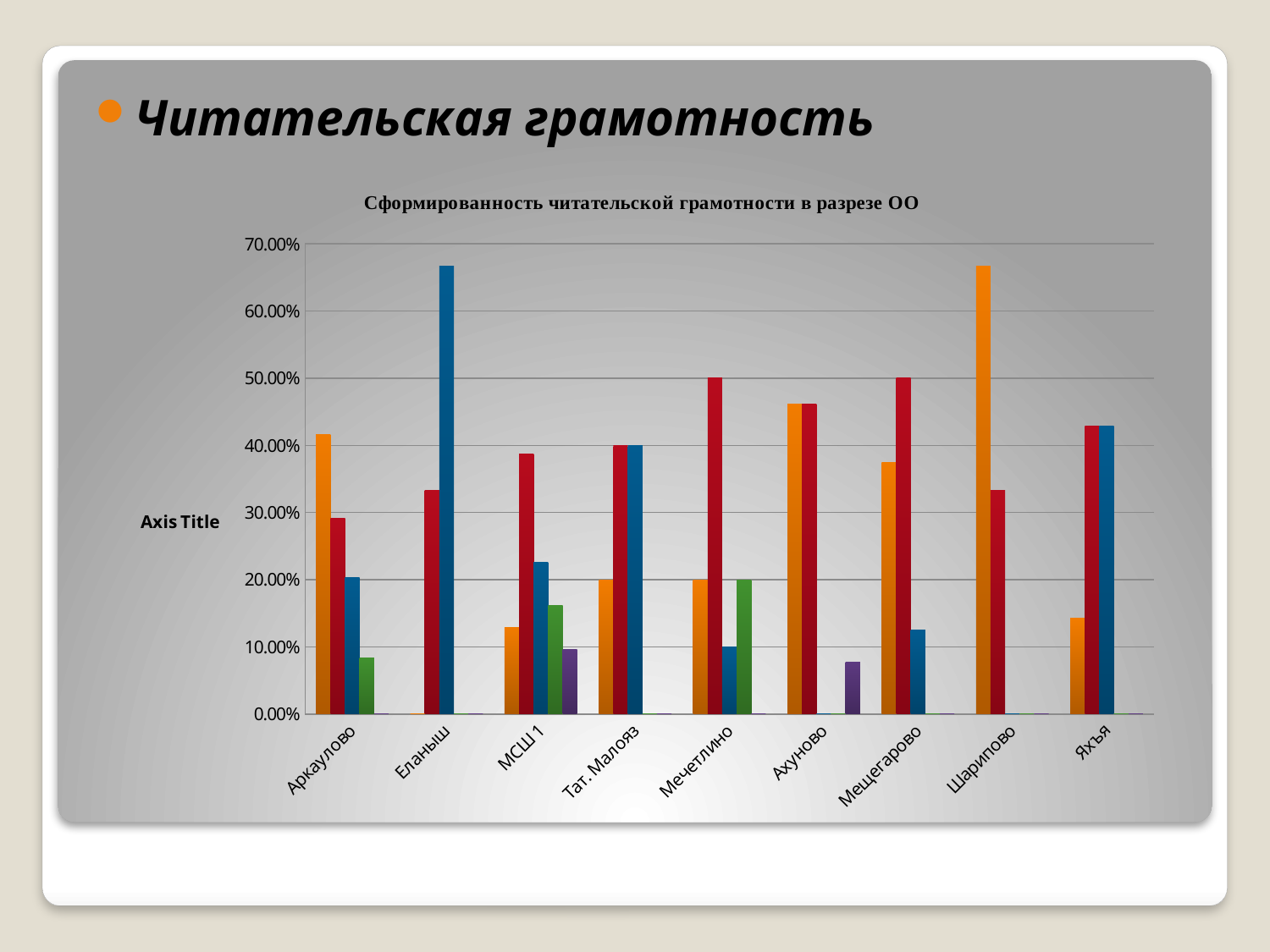
What text is shown as the vertical axis title of the chart? Axis Title Which category has the tallest orange bar? Шарипово Is the orange bar for Шарипово greater or less than 60.00%? greater How many categories are shown along the x axis of the chart? 9 Is the green bar for Аркаулово greater or less than 10.00%? less What is the title of the chart? Сформированность читательской грамотности в разрезе ОО For МСШ 1, which is larger: the red bar or the orange bar? the red bar What kind of chart is shown on the slide? bar chart Is the orange bar for Яхъя greater or less than 20.00%? less For Аркаулово, which is larger: the orange bar or the red bar? the orange bar